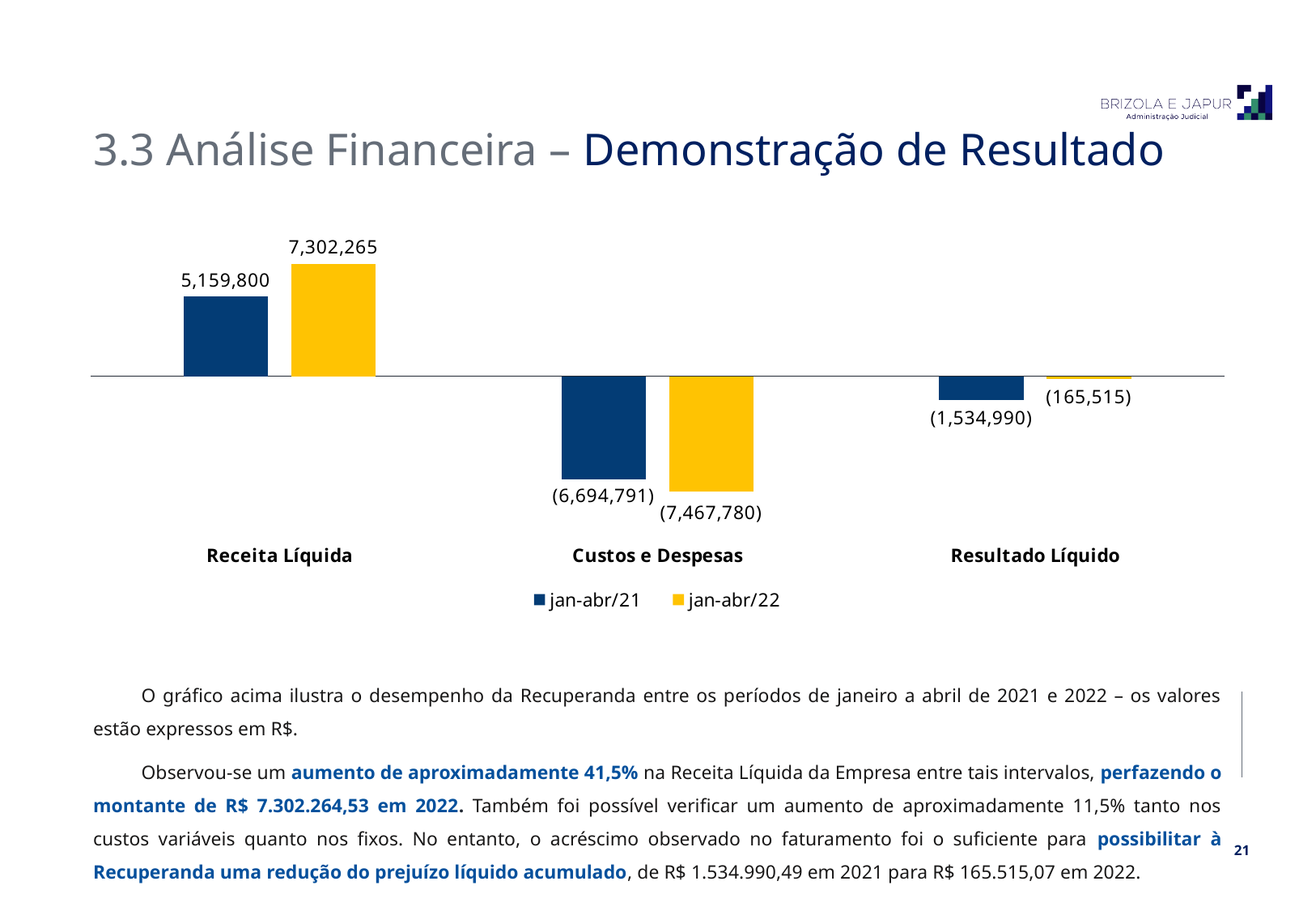
What is the value for Custos e Despesas in the jan-abr/22 series? (7,467,780) What is the value for Custos e Despesas in the jan-abr/21 series? (6,694,791) How many series does the legend list? 2 What is the value for Receita Líquida in the jan-abr/22 series? 7,302,265 What is the value for Receita Líquida in the jan-abr/21 series? 5,159,800 What is the value for Resultado Líquido in the jan-abr/22 series? (165,515) Which series has the larger Receita Líquida value, jan-abr/21 or jan-abr/22? jan-abr/22 What is the value for Resultado Líquido in the jan-abr/21 series? (1,534,990) By how much did Receita Líquida increase from jan-abr/21 to jan-abr/22? 2,142,465 What kind of chart is shown on the slide? Bar chart How many categories are shown on the x axis of the chart? 3 Which colour represents the jan-abr/22 series in the chart? Yellow